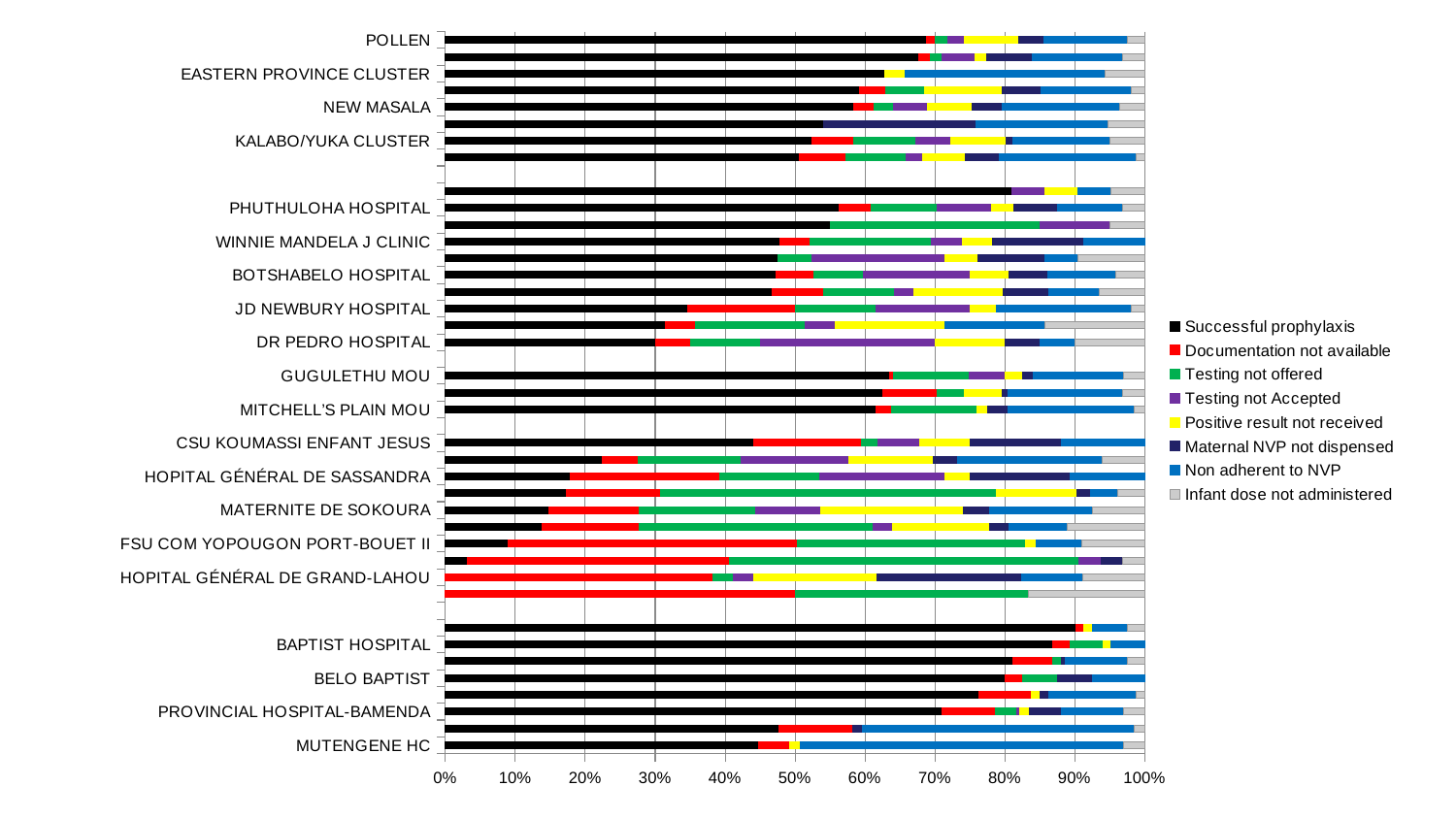
Which has the larger Successful prophylaxis share, GUGULETHU MOU or HOPITAL GÉNÉRAL DE SASSANDRA? GUGULETHU MOU What kind of chart is shown on the slide? stacked bar chart Is the Successful prophylaxis value for DR PEDRO HOSPITAL greater or less than 40%? less Which series is shown in black in the legend? Successful prophylaxis Is the Successful prophylaxis value for POLLEN greater or less than 60%? greater Which has the larger Successful prophylaxis share, BAPTIST HOSPITAL or MUTENGENE HC? BAPTIST HOSPITAL How many series does the legend list? 8 Is the Successful prophylaxis value for MUTENGENE HC greater or less than 50%? less Which series is shown in yellow in the legend? Positive result not received Which has the larger Successful prophylaxis share, JD NEWBURY HOSPITAL or PHUTHULOHA HOSPITAL? PHUTHULOHA HOSPITAL